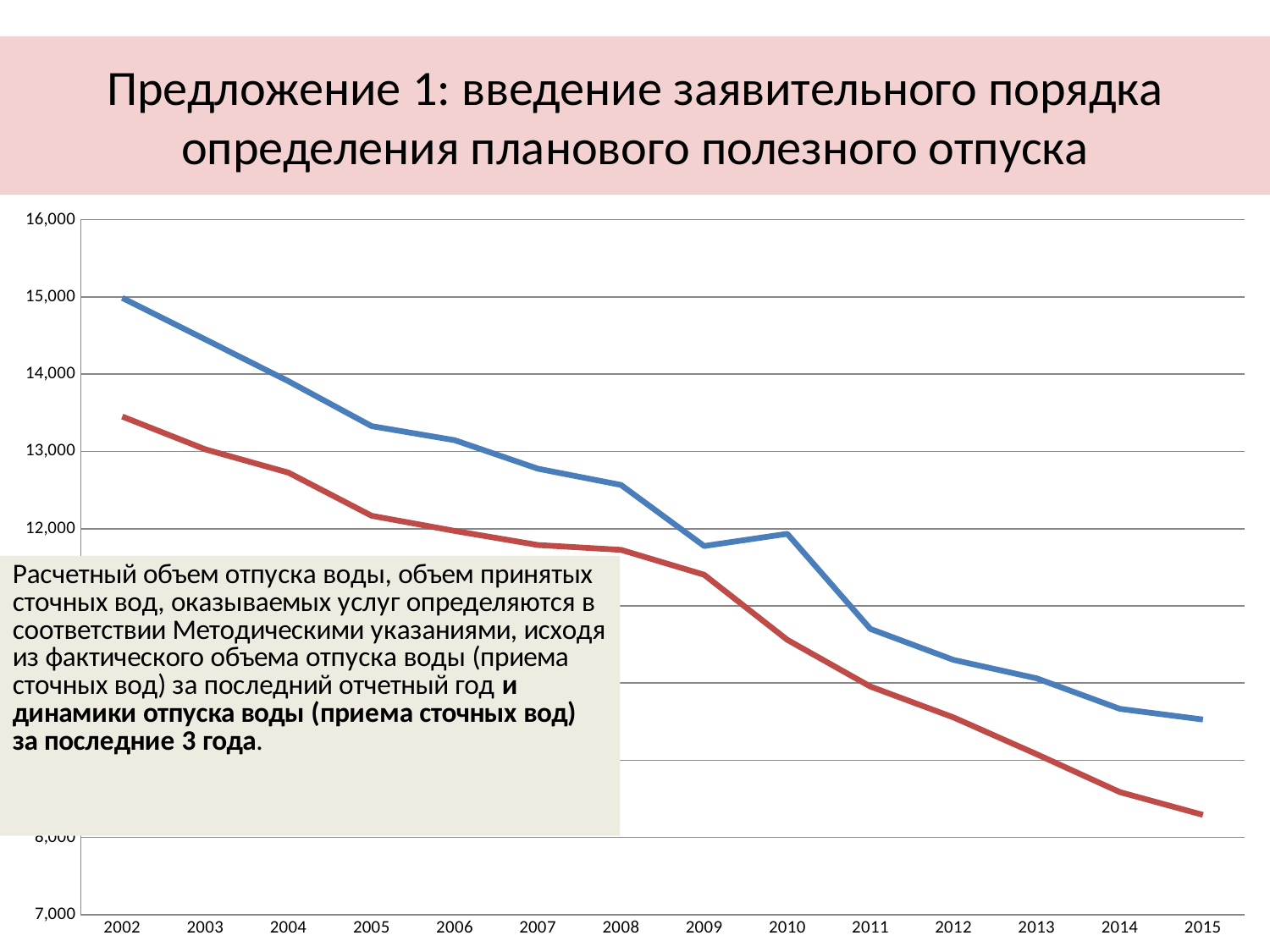
Which line has the higher value in 2002, the blue line or the red line? blue line Is the value of the blue line in 2002 greater or less than 14,000? greater Is the value of the blue line in 2009 greater or less than 12,000? less How many years are shown along the x axis of the chart? 14 Is the value of the red line in 2008 greater or less than 12,000? less In which year is the red line at its lowest value? 2015 In which year is the blue line at its highest value? 2002 What is the last year shown on the x axis? 2015 What is the first year shown on the x axis? 2002 What kind of chart is shown on the slide? line chart How many lines are plotted on the chart? 2 Do the values of the blue line rise or fall from 2002 to 2015? fall